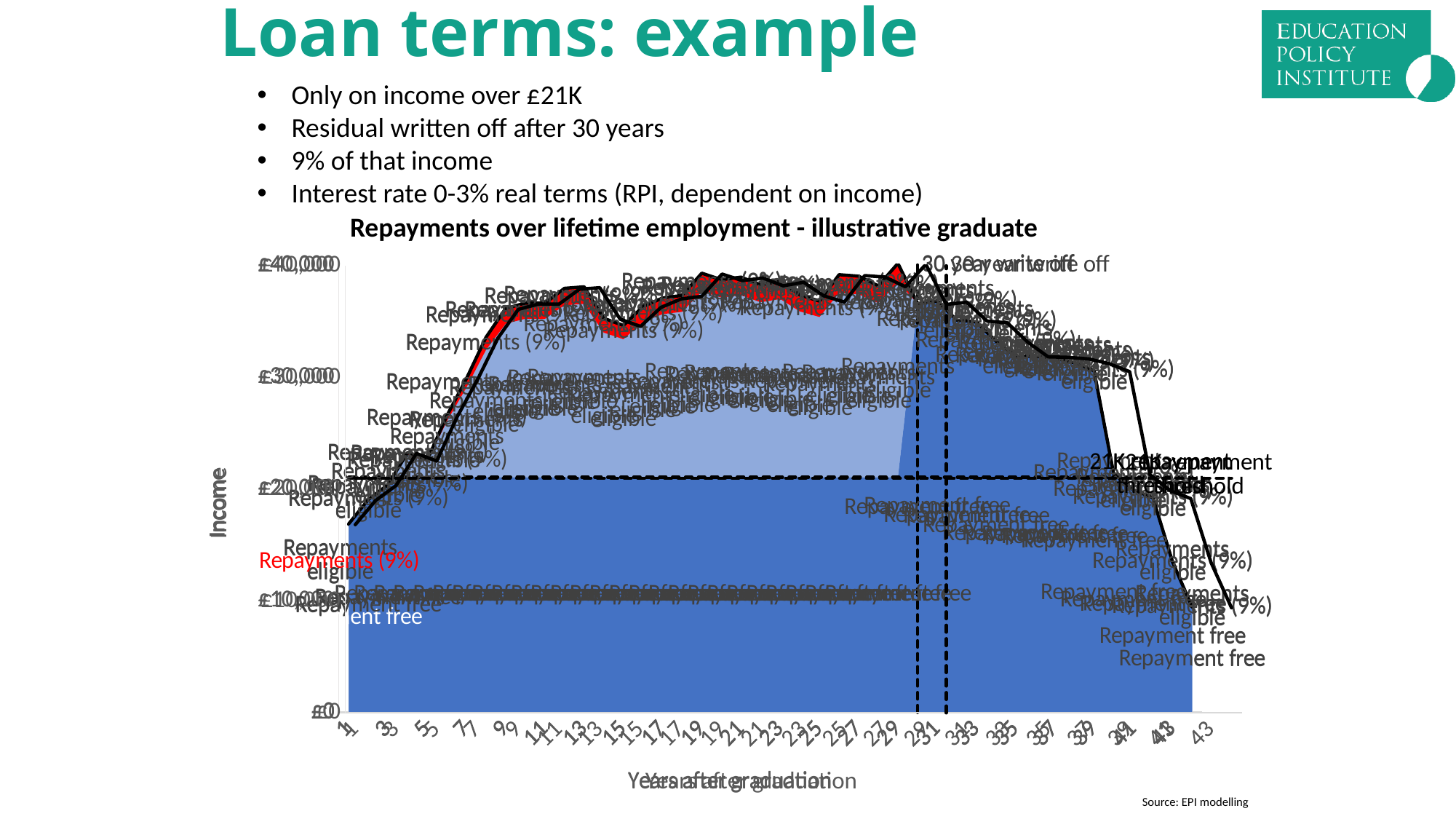
What kind of chart is shown on the slide? area chart Is the peak income shown on the chart greater or less than £30,000? greater Is the income at year 15 after graduation greater or less than £20,000? greater Is the income at year 20 after graduation greater or less than £30,000? greater What is the title of the chart? Repayments over lifetime employment - illustrative graduate What does the horizontal dashed line on the chart represent? 21K repayment threshold Does income rise or fall after year 30 on the chart? fall Does income rise or fall between year 1 and year 10 after graduation? rise